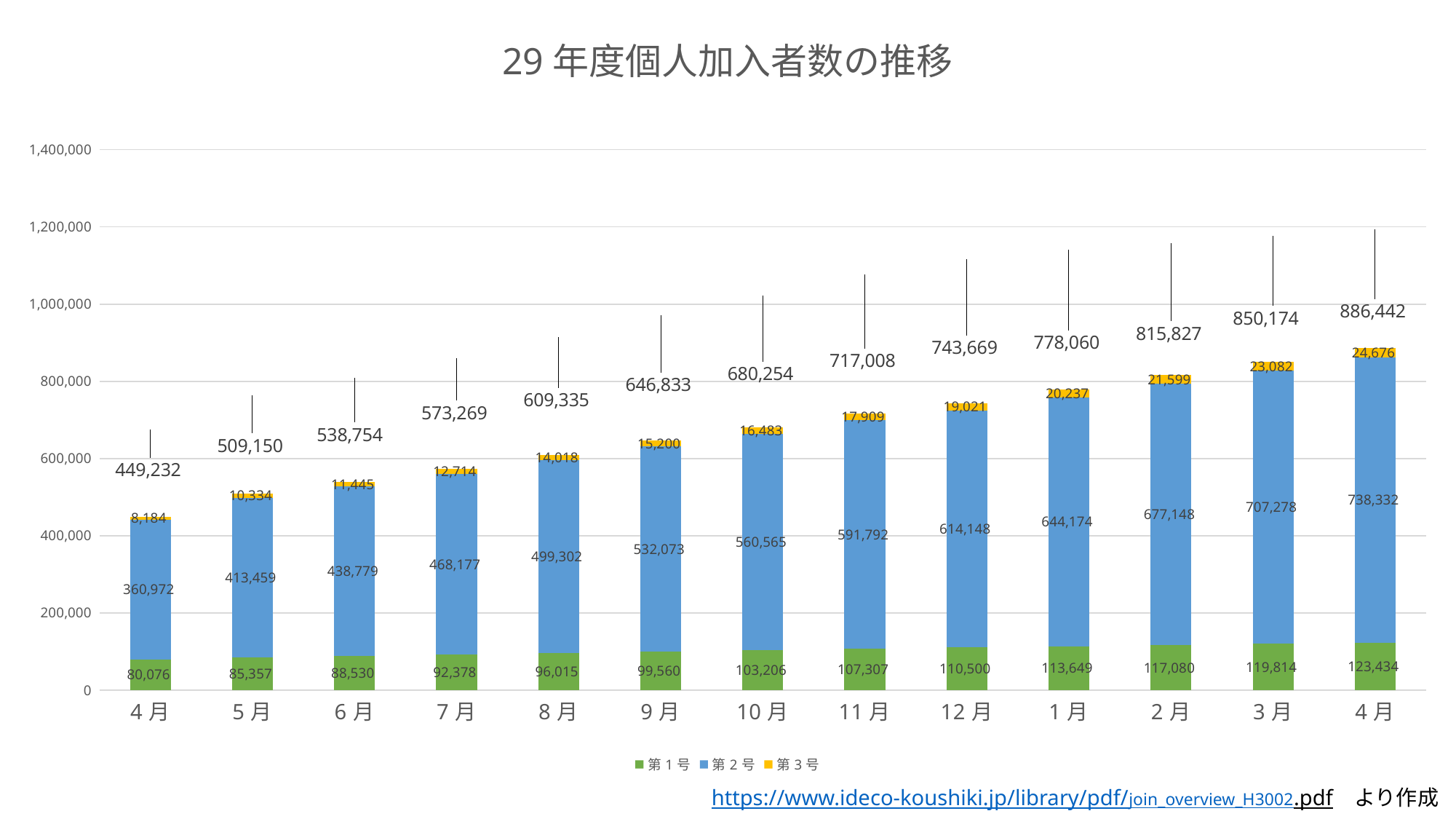
Which is larger, the 第2号 value for 9月 or for 8月? 9月 What is the total of the stacked bar for 7月? 573,269 What is the value of 第3号 for 12月? 19,021 How many series does the legend list? 3 What is the difference between the 第1号 values for 3月 and 2月? 2,734 What is the difference between the totals for 12月 and 11月? 26,661 Which month has the highest value for 第2号? 4月 (the rightmost bar) What is the value of 第2号 for 10月? 560,565 How many bars (months) are shown on the x axis? 13 Which month has the lowest total? 4月 (the leftmost bar) What is the value of 第1号 for 1月? 113,649 Is the total for 11月 greater or less than 600,000? greater